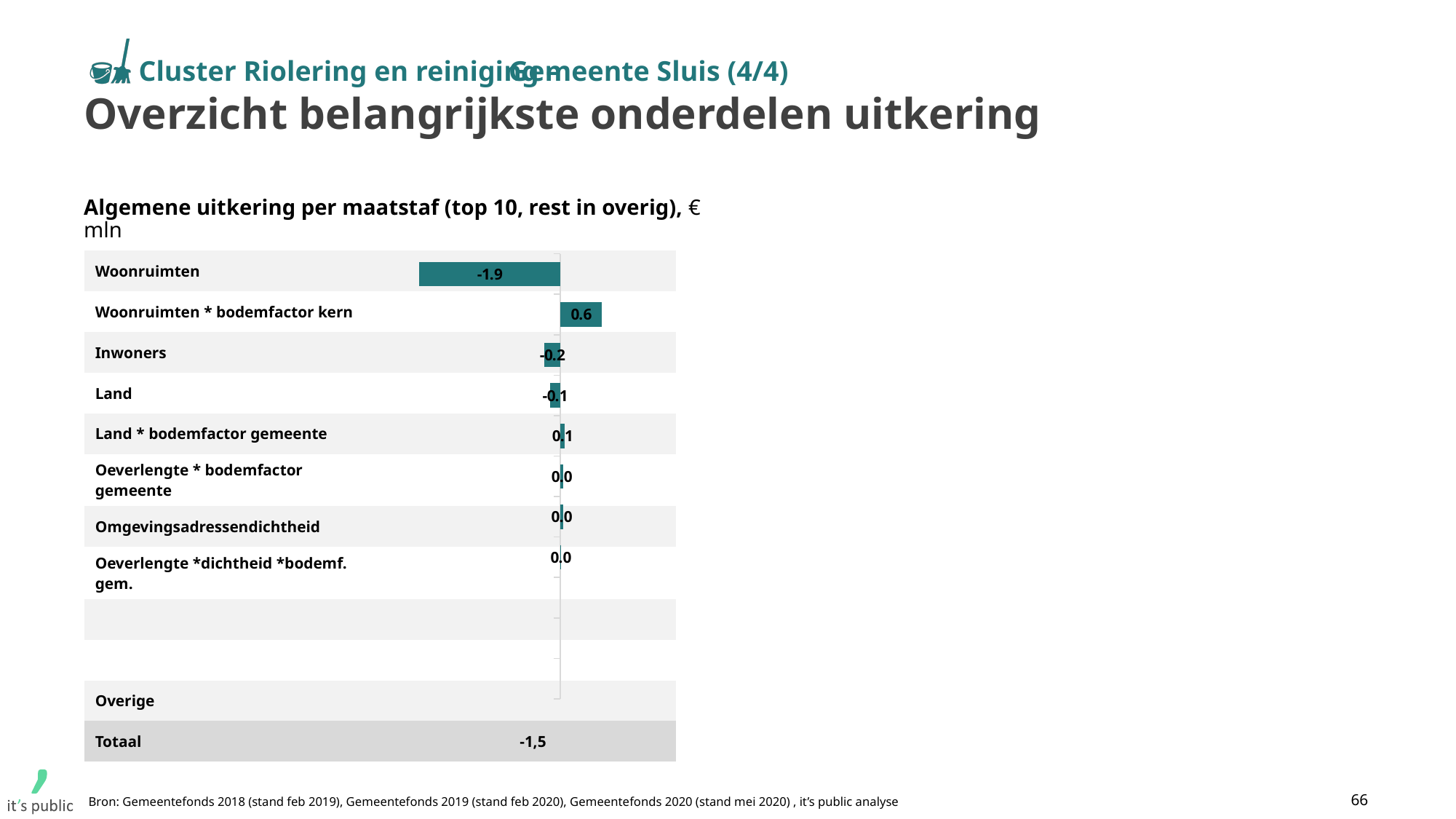
Which category has the highest value? Woonruimten * bodemfactor kern What is the value for Woonruimten * bodemfactor kern? 0.6 What is the value for Woonruimten? -1.9 What is the Totaal value shown at the bottom of the chart? -1,5 What kind of chart is shown on the slide? Bar chart What is the value for Land? -0.1 Which is larger, the value for Inwoners or the value for Land? Land What is the difference between the values for Woonruimten * bodemfactor kern and Woonruimten? 2.5 What is the title of the chart? Algemene uitkering per maatstaf (top 10, rest in overig), € mln What is the value for Land * bodemfactor gemeente? 0.1 What is the value for Inwoners? -0.2 Which category has the lowest (most negative) value? Woonruimten